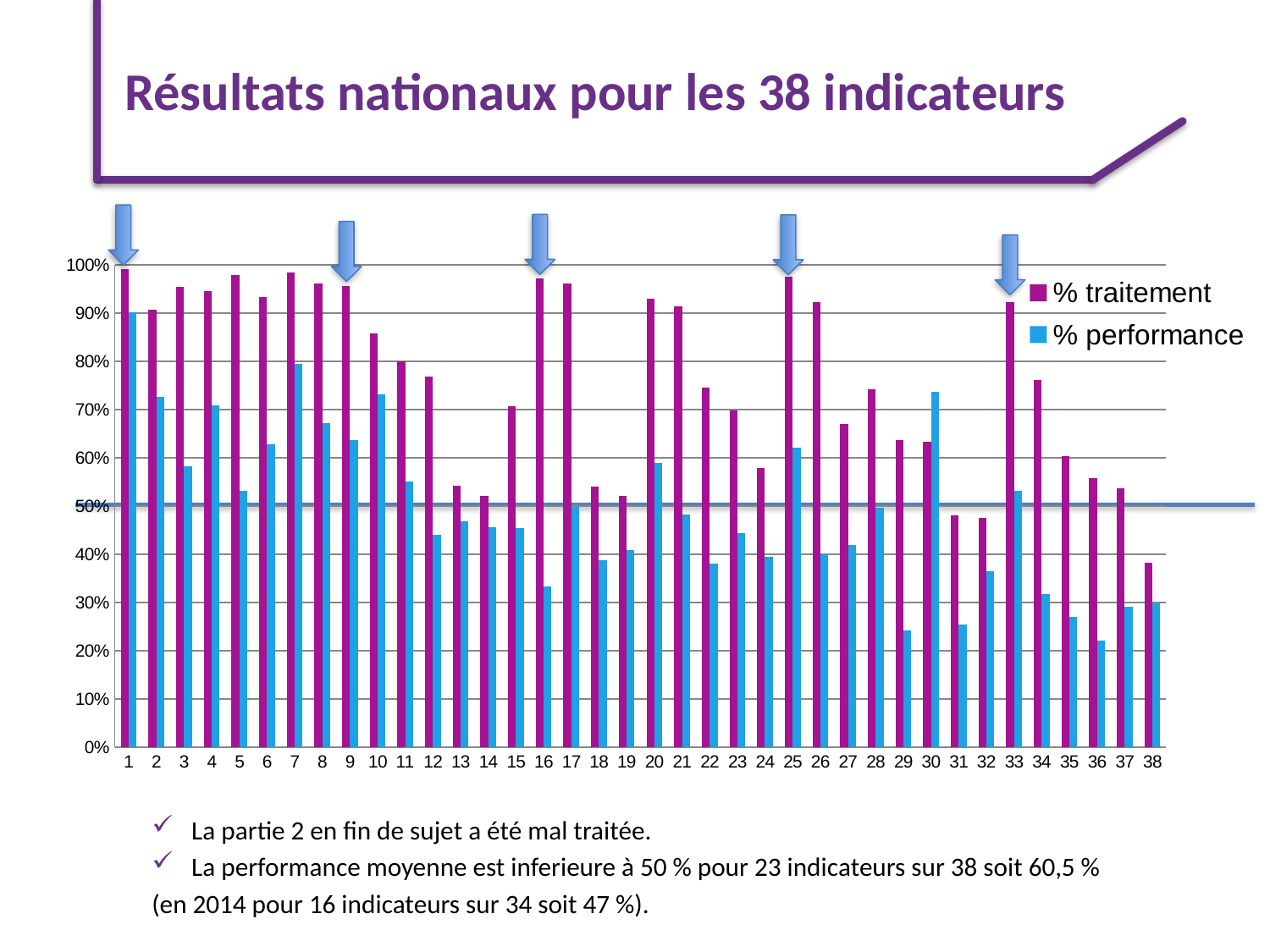
What is the title of the chart on the slide? Résultats nationaux pour les 38 indicateurs Is the % traitement value for indicator 1 greater or less than 90%? greater Is the % performance value for indicator 36 greater or less than 30%? less What kind of chart is shown on the slide? bar chart Is the % performance value for indicator 38 greater or less than 40%? less How many indicators (categories) are plotted along the x axis? 38 Which indicator has the highest % performance value? 1 Overall, do the % traitement values rise or fall from indicator 1 to indicator 38? fall Which indicator has the lowest % traitement value? 38 How many series does the legend list? 2 For indicator 30, which is larger: % traitement or % performance? % performance